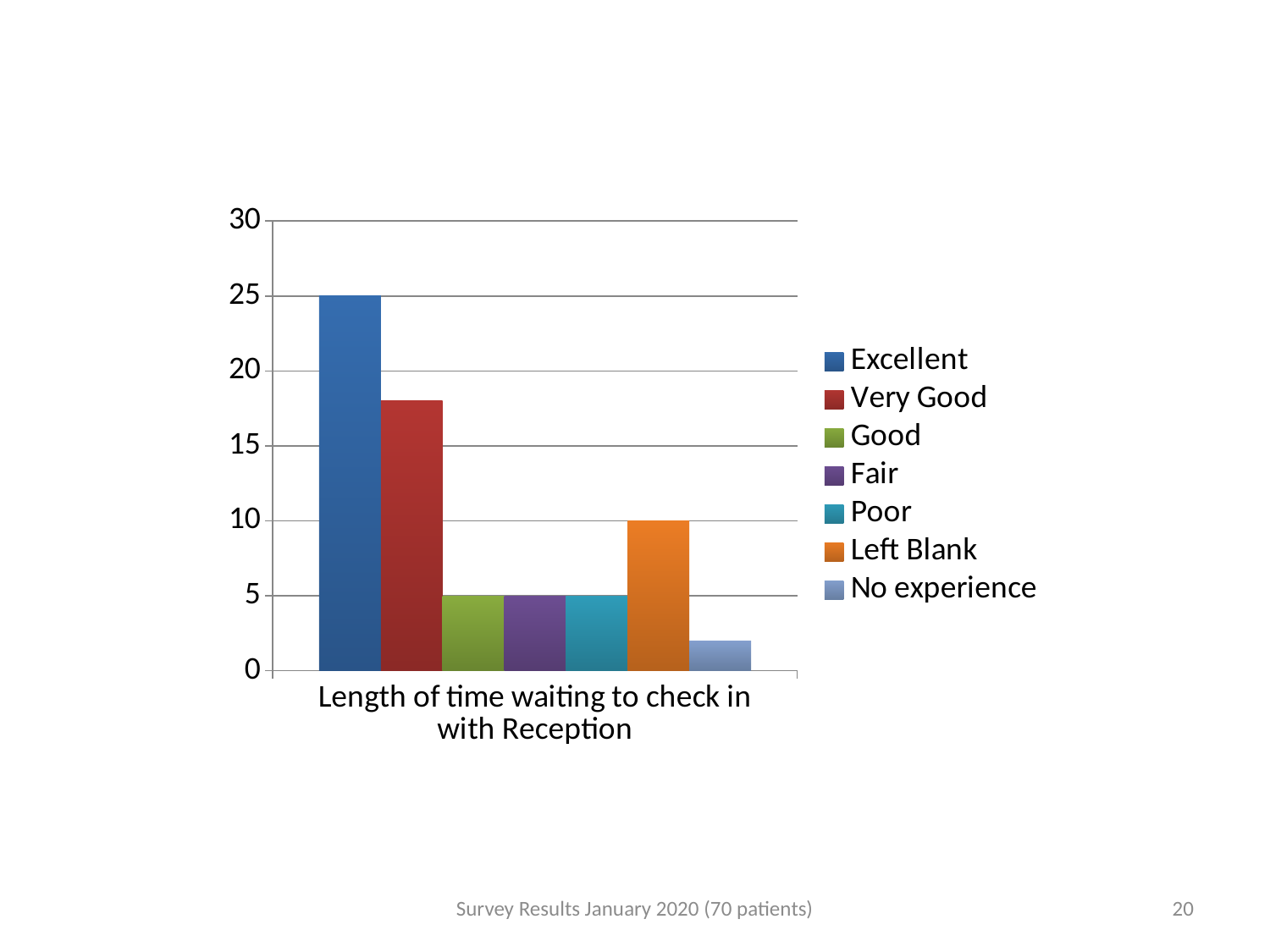
What is the value for Excellent? 25 What is the value for Good? 5 Which series has the lowest value? No experience What is the category label shown on the x axis? Length of time waiting to check in with Reception Is the value for Very Good greater or less than 15? greater Which is larger, the value for Very Good or the value for Left Blank? Very Good What kind of chart is shown on the slide? bar chart Which series has the highest value? Excellent What is the value for Left Blank? 10 How many series does the legend list? 7 Is the value for No experience greater or less than 5? less What is the difference between the values for Excellent and Left Blank? 15